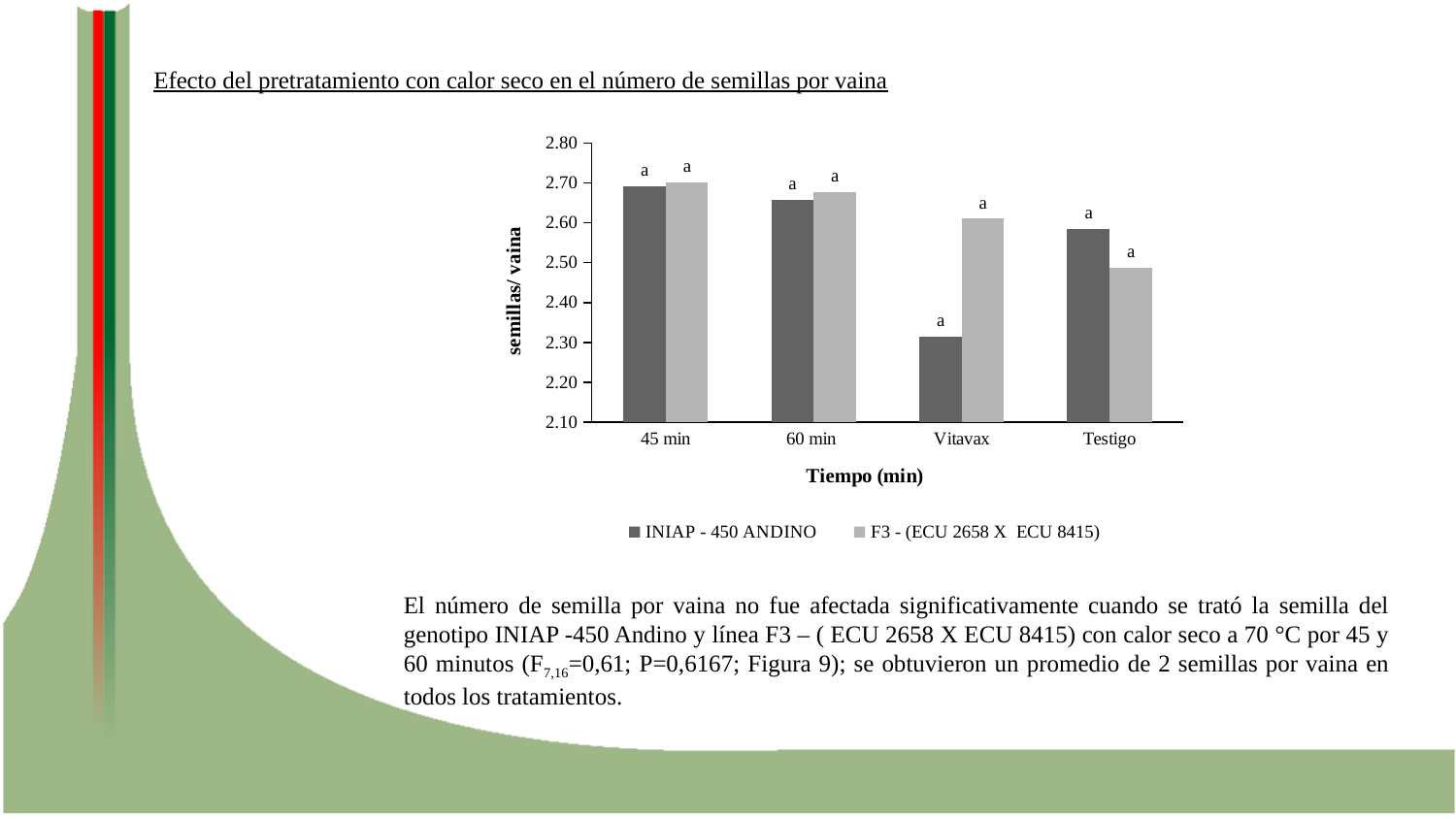
What kind of chart is shown on the slide? bar chart How many series does the legend list? 2 What is the label of the y axis? semillas/ vaina How many categories are shown on the x axis? 4 Which category has the lowest value for F3 - (ECU 2658 X ECU 8415)? Testigo For Vitavax, which series has the larger value, INIAP - 450 ANDINO or F3 - (ECU 2658 X ECU 8415)? F3 - (ECU 2658 X ECU 8415) Is the value for INIAP - 450 ANDINO at Vitavax greater or less than 2.40? less What is the label of the x axis? Tiempo (min) Which category has the lowest value for INIAP - 450 ANDINO? Vitavax Is the value for F3 - (ECU 2658 X ECU 8415) at Vitavax greater or less than 2.50? greater For Testigo, which series has the larger value, INIAP - 450 ANDINO or F3 - (ECU 2658 X ECU 8415)? INIAP - 450 ANDINO Is the value for INIAP - 450 ANDINO at 45 min greater or less than 2.60? greater